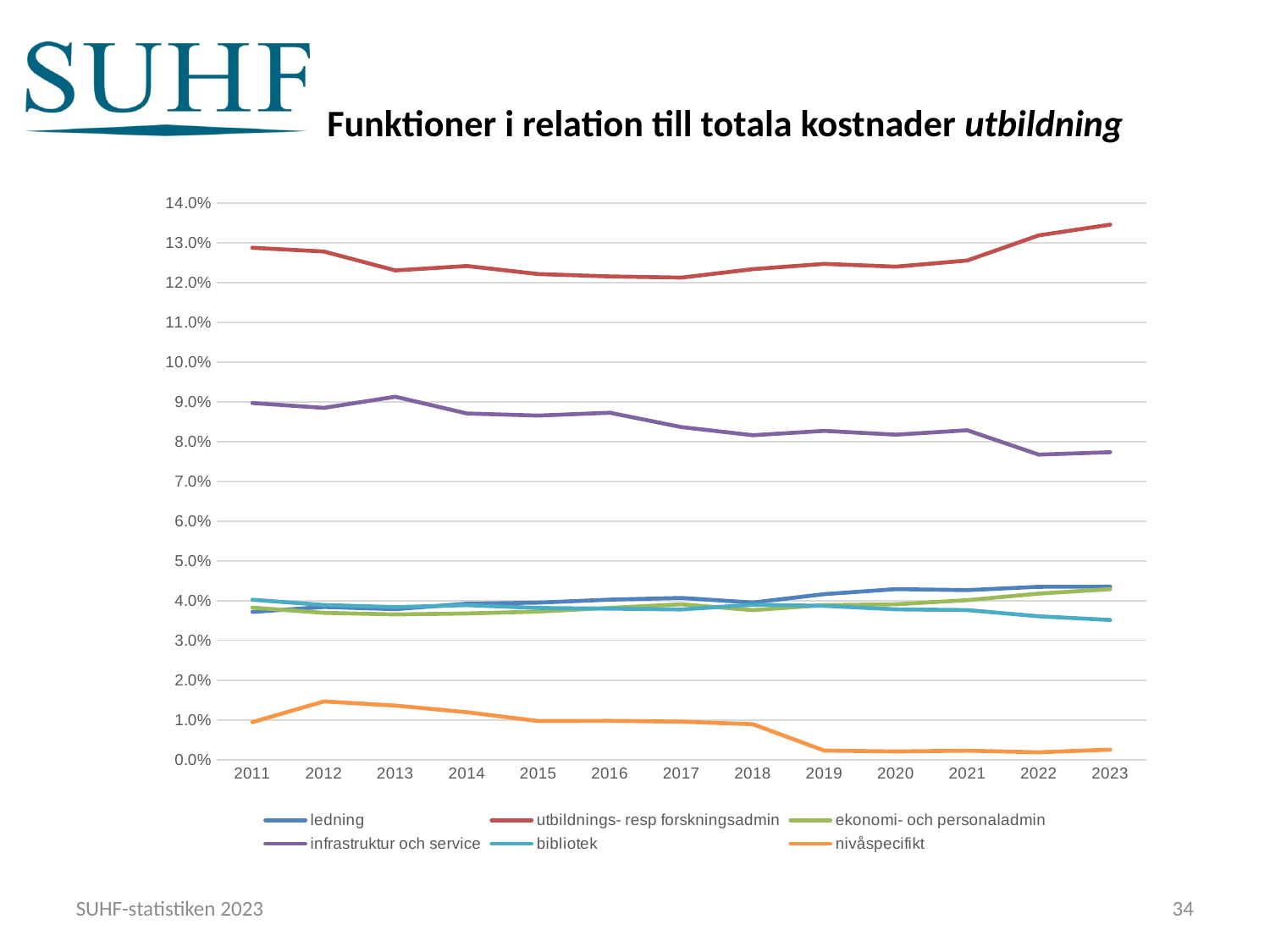
Is the value for nivåspecifikt in 2019 greater or less than 1.0%? less What is the title of the chart? Funktioner i relation till totala kostnader utbildning Does the infrastruktur och service series rise or fall from 2011 to 2023? fall Is the value for utbildnings- resp forskningsadmin in 2023 greater or less than 13.0%? greater Is the value for infrastruktur och service in 2022 greater or less than 8.0%? less How many years are plotted along the x axis? 13 Which series has the lowest values across all years? nivåspecifikt What kind of chart is shown on the slide? line chart Which series has the highest values across all years? utbildnings- resp forskningsadmin In which year does the utbildnings- resp forskningsadmin series reach its highest value? 2023 How many series does the legend list? 6 In 2023, which is larger: ledning or bibliotek? ledning